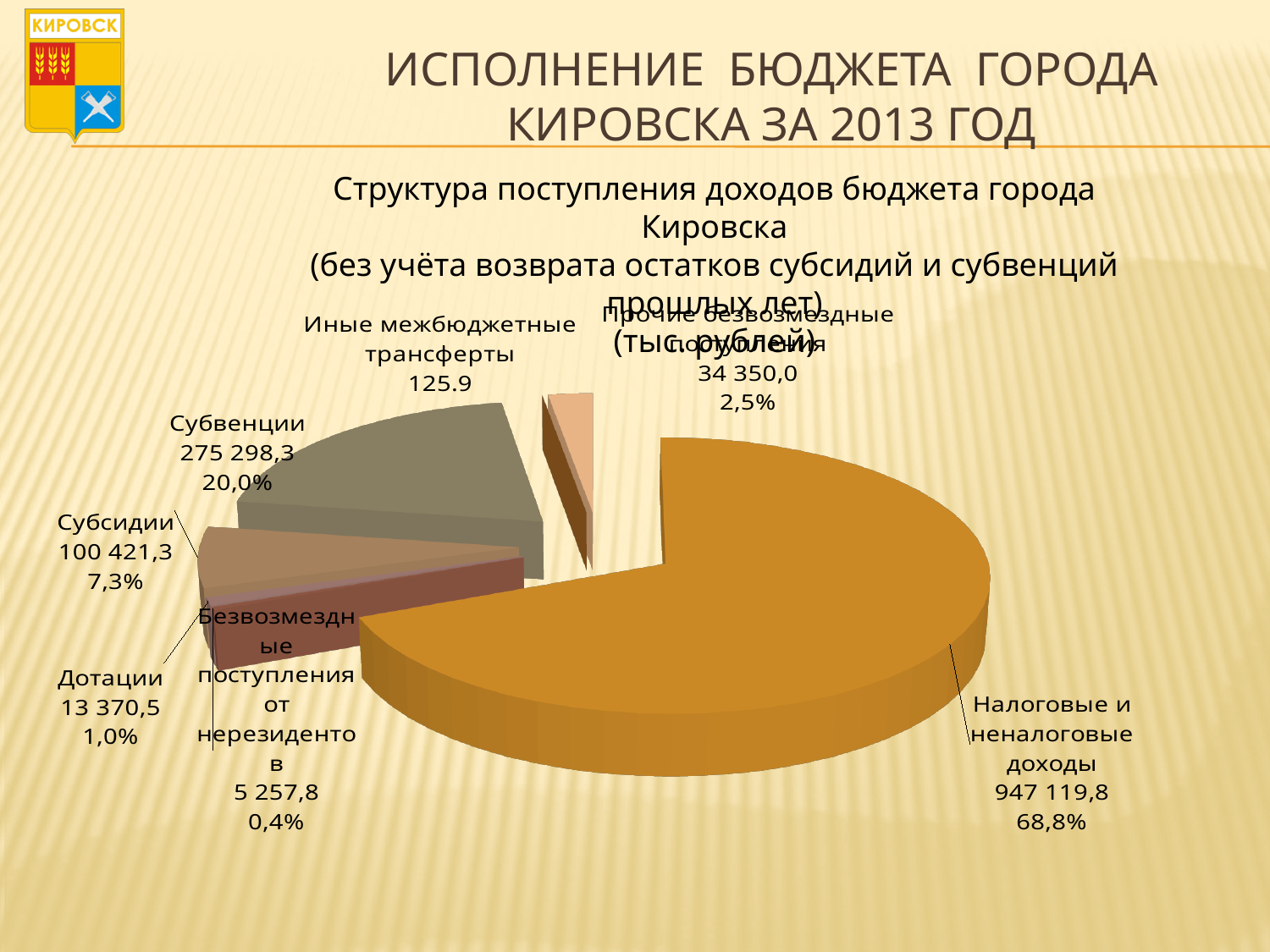
What kind of chart is shown on the slide? pie chart What is the value for Субвенции? 275 298,3 Which is larger: Дотации or Безвозмездные поступления от нерезидентов? Дотации What share of the pie does Прочие безвозмездные поступления represent? 2,5% What is the value for Налоговые и неналоговые доходы? 947 119,8 What is the value for Дотации? 13 370,5 What is the value for Субсидии? 100 421,3 What is the difference between the values for Субвенции and Субсидии? 174 877,0 Which category has the smallest value? Иные межбюджетные трансферты How many categories are shown in the pie chart? 7 Which category has the largest slice of the pie? Налоговые и неналоговые доходы What share of the pie does Субвенции represent? 20,0%